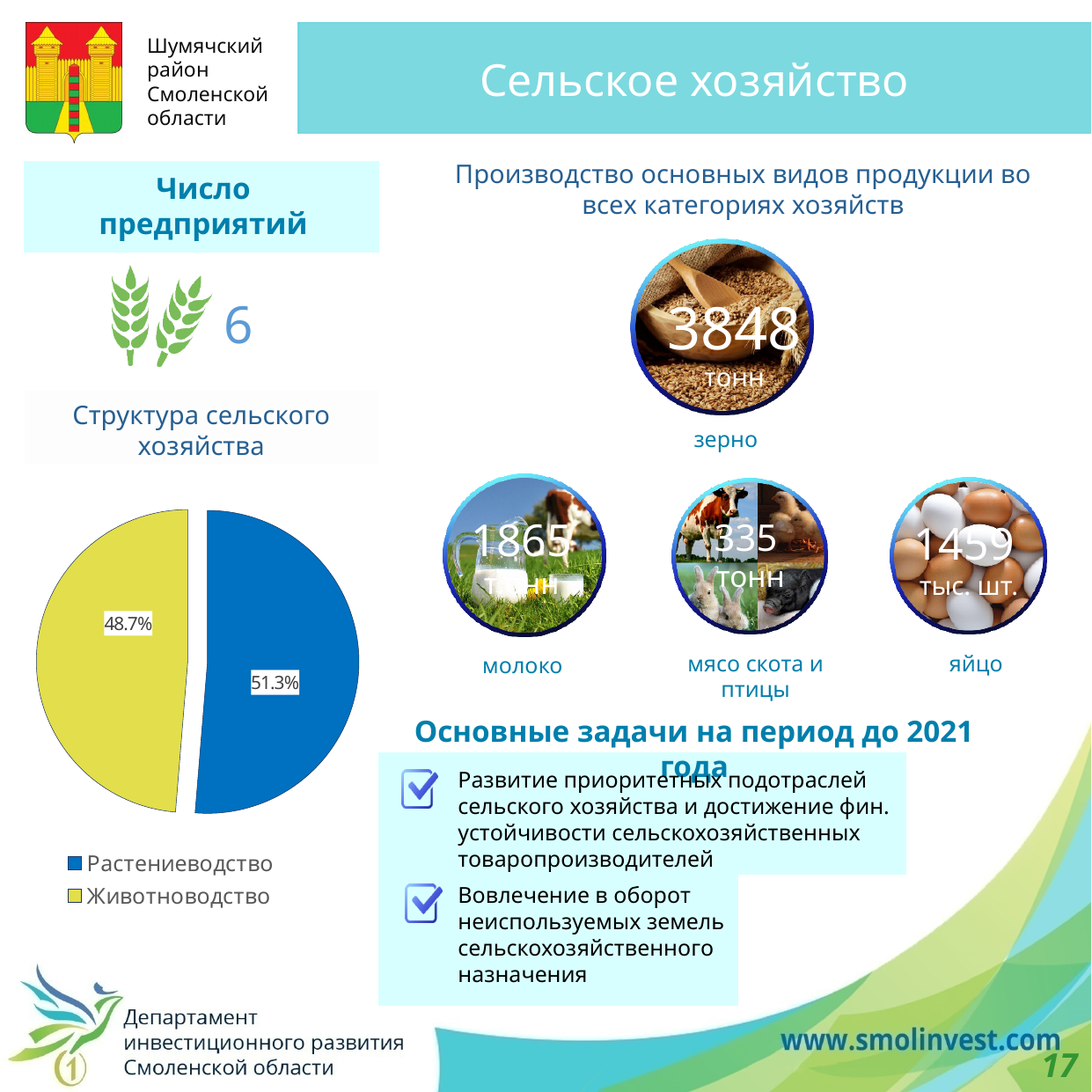
In the pie chart "Структура сельского хозяйства", which category has the smaller share? Животноводство How many entries does the legend of the pie chart "Структура сельского хозяйства" list? 2 In the pie chart "Структура сельского хозяйства", what share does Животноводство have? 48.7% In the pie chart "Структура сельского хозяйства", what colour is the Животноводство slice? yellow How many slices does the pie chart "Структура сельского хозяйства" have? 2 In the pie chart "Структура сельского хозяйства", what colour is the Растениеводство slice? blue In the pie chart "Структура сельского хозяйства", what share does Растениеводство have? 51.3% In the pie chart "Структура сельского хозяйства", which category has the larger share? Растениеводство In the pie chart "Структура сельского хозяйства", is the share of Животноводство larger or smaller than the share of Растениеводство? smaller In the pie chart "Структура сельского хозяйства", what is the combined share of Растениеводство and Животноводство? 100% In the pie chart "Структура сельского хозяйства", by how many percentage points does Растениеводство exceed Животноводство? 2.6 What kind of chart is shown under the heading "Структура сельского хозяйства"? pie chart